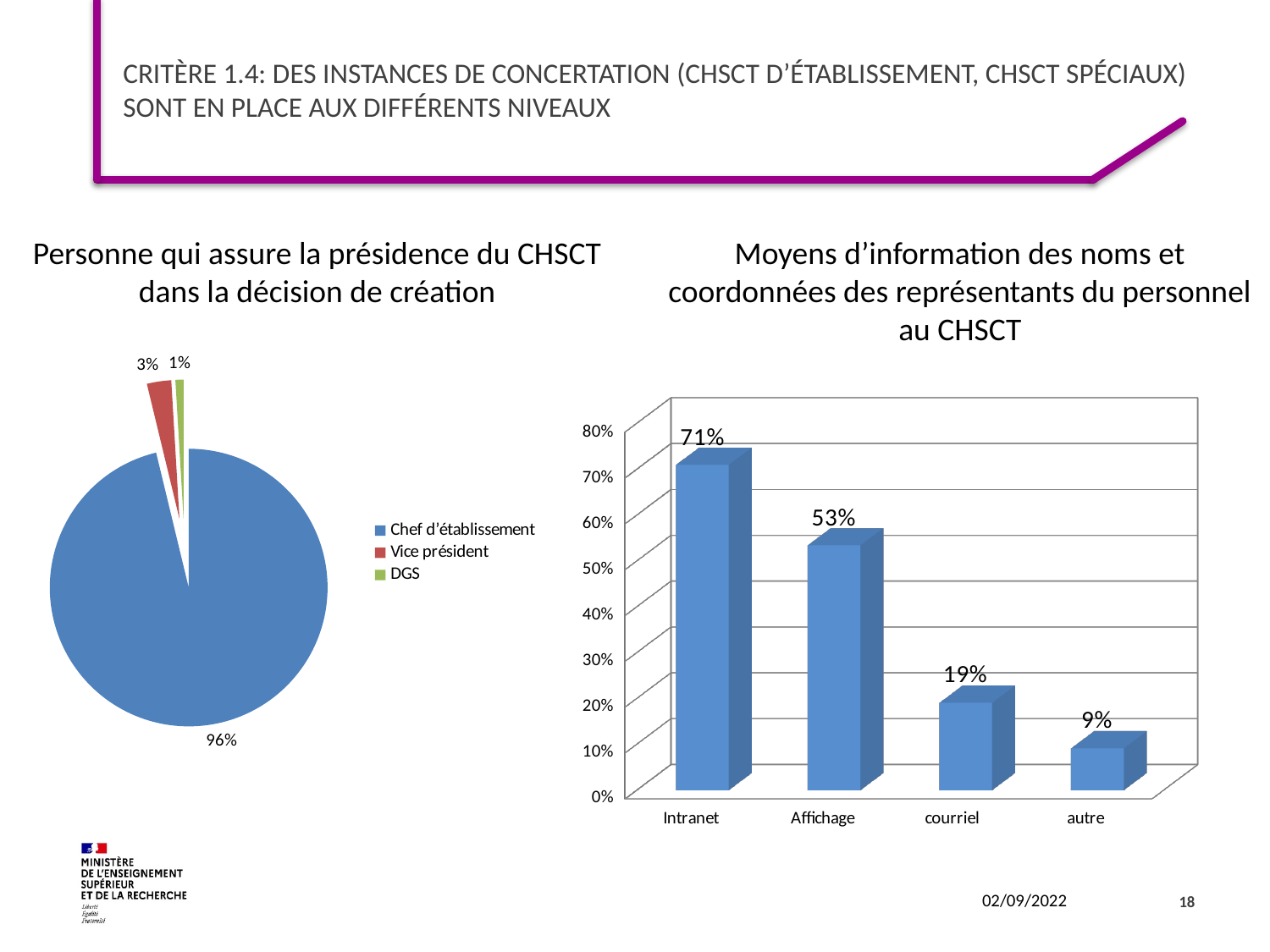
In the bar chart on the right, which category has the lowest value? autre In the pie chart on the left, what share does Chef d'établissement have? 96% In the pie chart on the left, what share does DGS have? 1% How many categories are shown in the bar chart on the right? 4 In the bar chart on the right, what is the value for courriel? 19% In the bar chart on the right, what is the difference between the values for Intranet and Affichage? 18% How many entries does the legend of the pie chart on the left list? 3 In the bar chart on the right, what is the value for Intranet? 71% In the bar chart on the right, which category has the highest value? Intranet Do the values in the bar chart on the right rise or fall from left to right? fall In the bar chart on the right, which is larger, the value for Affichage or the value for courriel? Affichage What kind of chart is the chart on the left, 'Personne qui assure la présidence du CHSCT dans la décision de création'? pie chart